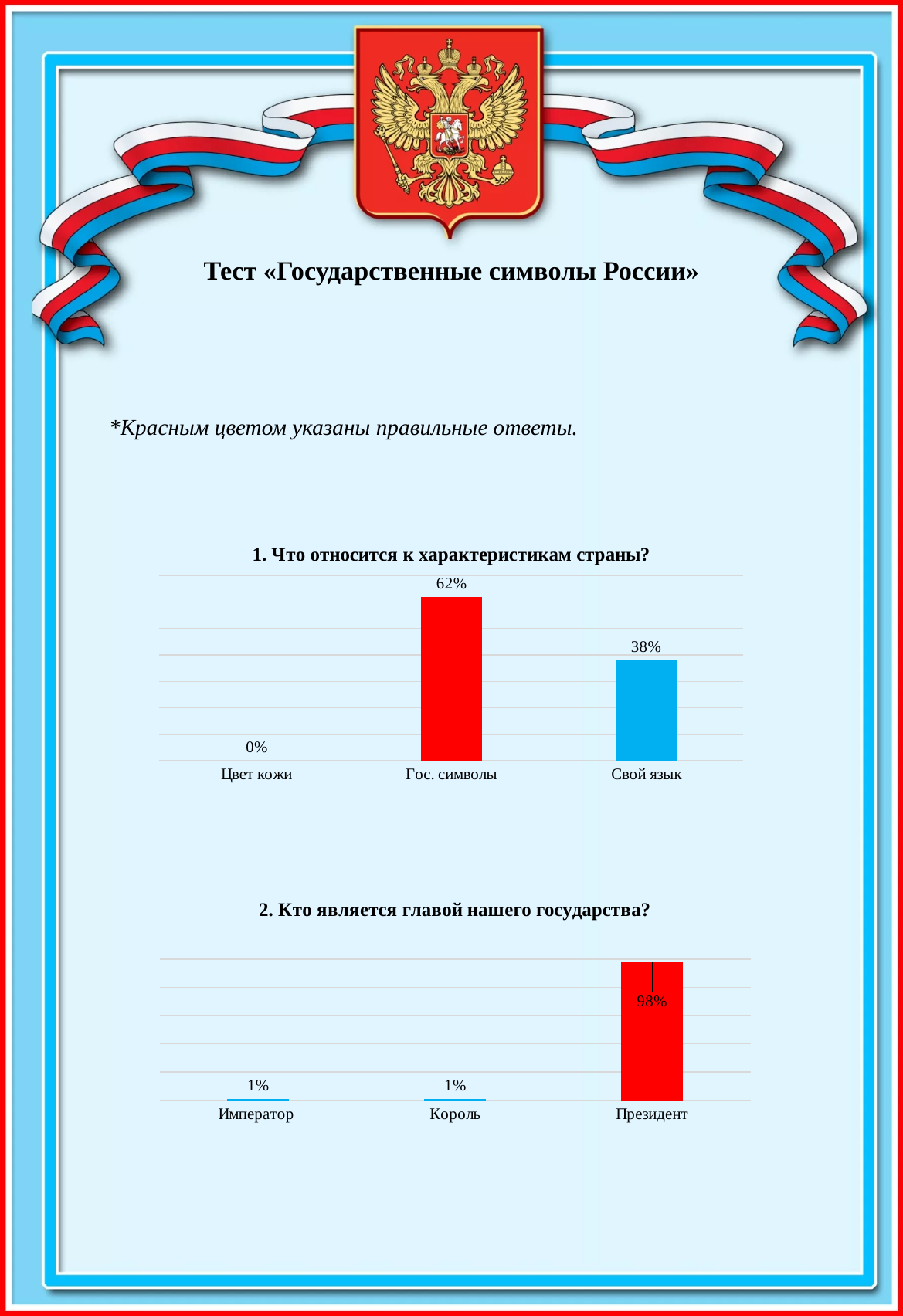
In the chart "1. Что относится к характеристикам страны?", which category has the highest value? Гос. символы In the chart "1. Что относится к характеристикам страны?", what is the value for Цвет кожи? 0% In the chart "1. Что относится к характеристикам страны?", what is the value for Гос. символы? 62% In the chart "2. Кто является главой нашего государства?", which category has the highest value? Президент In the chart "2. Кто является главой нашего государства?", what is the difference between the values for Президент and Король? 97% In the chart "1. Что относится к характеристикам страны?", which category has the lowest value? Цвет кожи What type of chart is "2. Кто является главой нашего государства?"? Bar chart In the chart "1. Что относится к характеристикам страны?", what is the value for Свой язык? 38% In the chart "1. Что относится к характеристикам страны?", how many categories are shown? 3 In the chart "2. Кто является главой нашего государства?", what is the value for Президент? 98% In the chart "2. Кто является главой нашего государства?", what is the value for Император? 1% In the chart "1. Что относится к характеристикам страны?", what is the difference between the values for Гос. символы and Свой язык? 24%